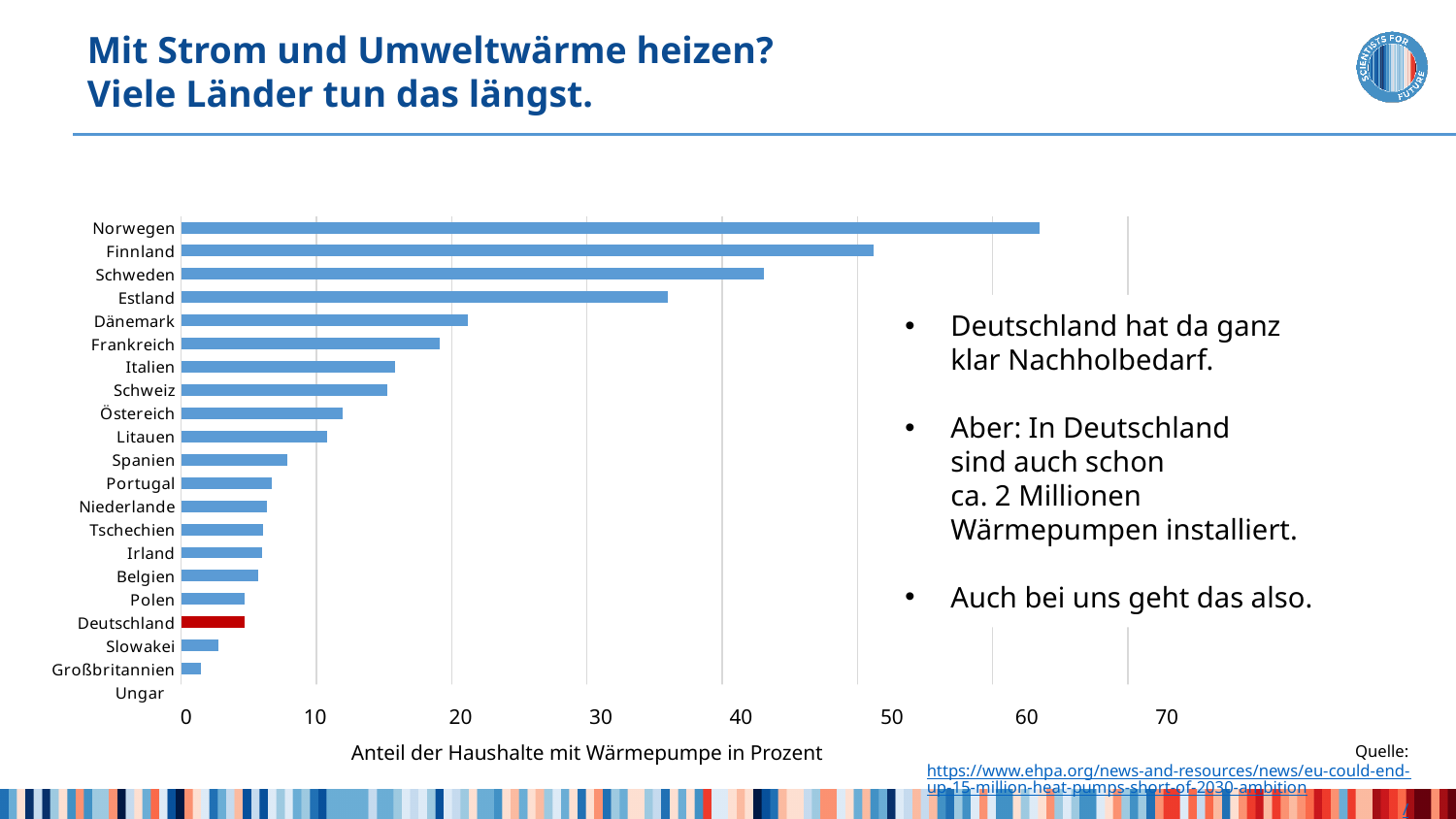
Which country has the lowest share of households with a heat pump? Ungar Is the value for Estland greater or less than 30? greater How many countries are listed on the chart? 21 Which has the larger value, Finnland or Schweden? Finnland Is the value for Deutschland greater or less than 10? less Which country has the highest share of households with a heat pump? Norwegen Which country's bar is highlighted in red? Deutschland Is the value for Norwegen greater or less than 60? greater What kind of chart is shown on the slide? bar chart Which has the larger value, Deutschland or Slowakei? Deutschland